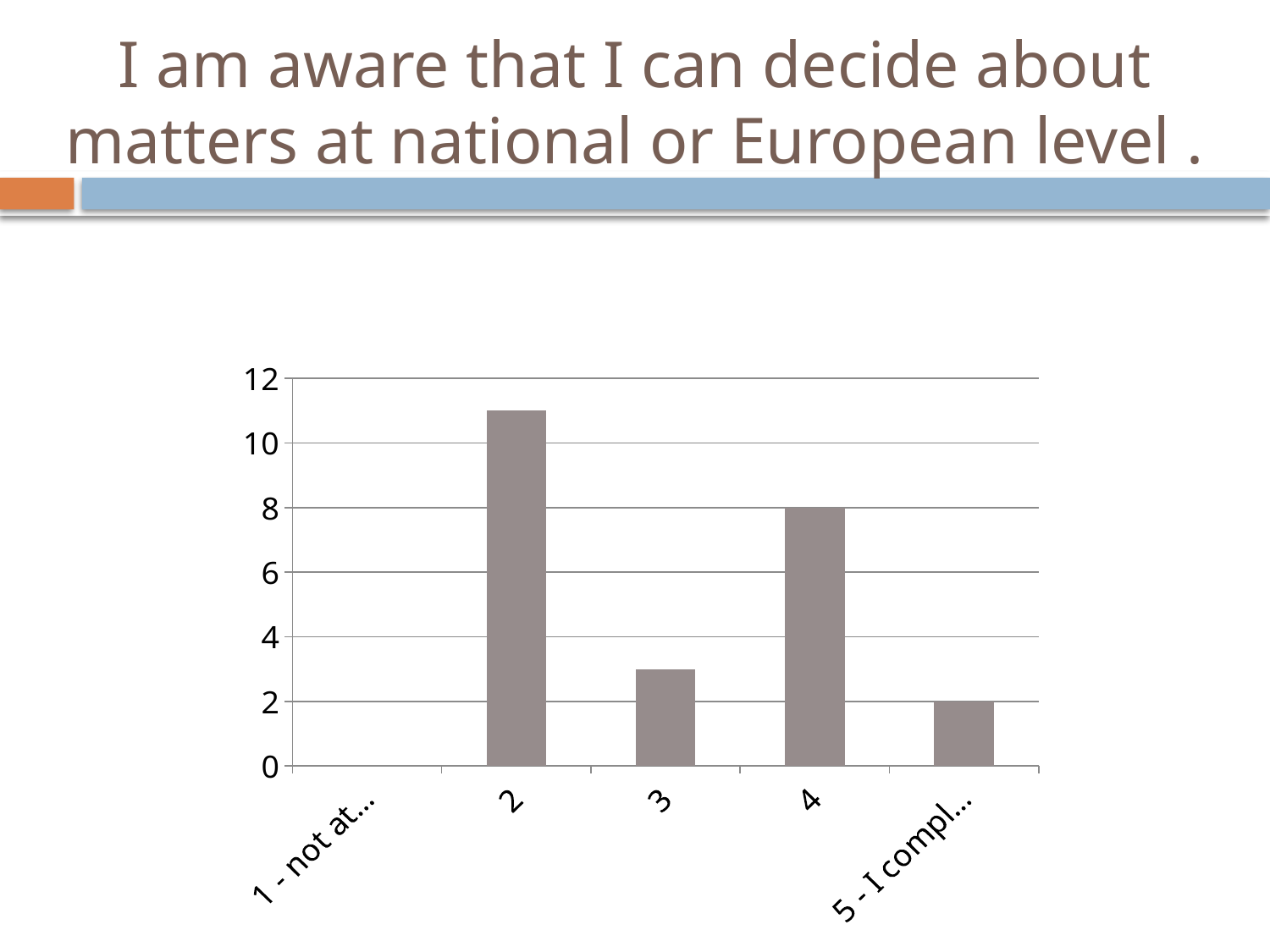
What kind of chart is shown on the slide? bar chart Is the value for category 3 greater or less than 2? greater Is the value for category 2 greater or less than 10? greater Which has a larger value, category 3 or category 4? 4 How many categories are shown on the x axis of the chart? 5 What is the value for category 4? 8 What is the value for the category labelled "5 - I compl..."? 2 Which category on the x axis has no bar at all? 1 - not at... Which category has the highest value? 2 Is the value for category 3 greater or less than 4? less What is the difference between the value for category 4 and the value for "5 - I compl..."? 6 What is the highest value shown on the vertical axis? 12